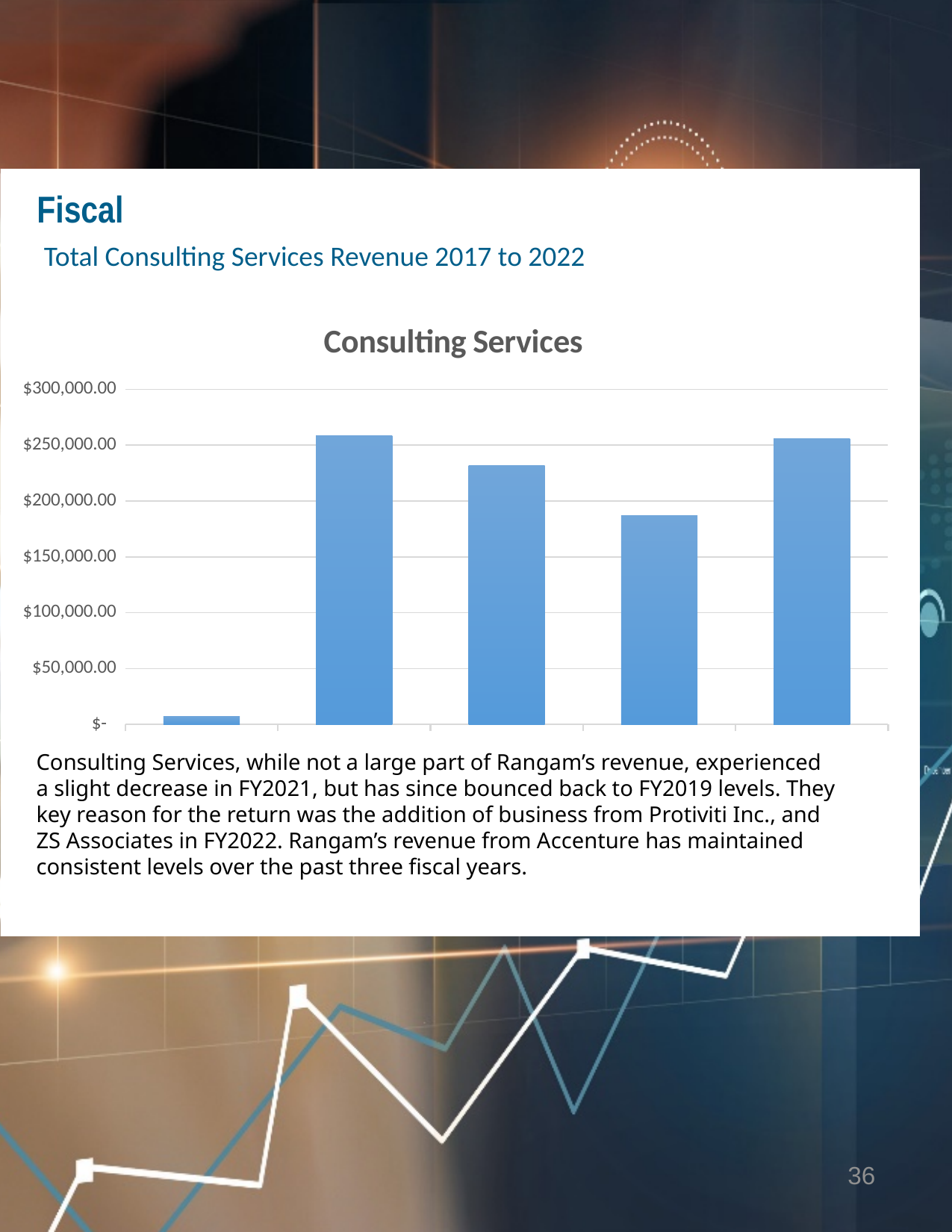
What is the highest value shown on the vertical axis of the chart? $300,000.00 What is the title of the chart? Consulting Services Which is larger, the third bar or the fourth bar? the third bar Is the value of the second bar greater or less than $250,000.00? greater Is the value of the fourth bar greater or less than $200,000.00? less Which bar in the chart is the lowest? the first bar Is the value of the fourth bar greater or less than $150,000.00? greater Which is larger, the second bar or the third bar? the second bar How many bars are plotted in the chart? 5 What kind of chart is shown on the slide? bar chart